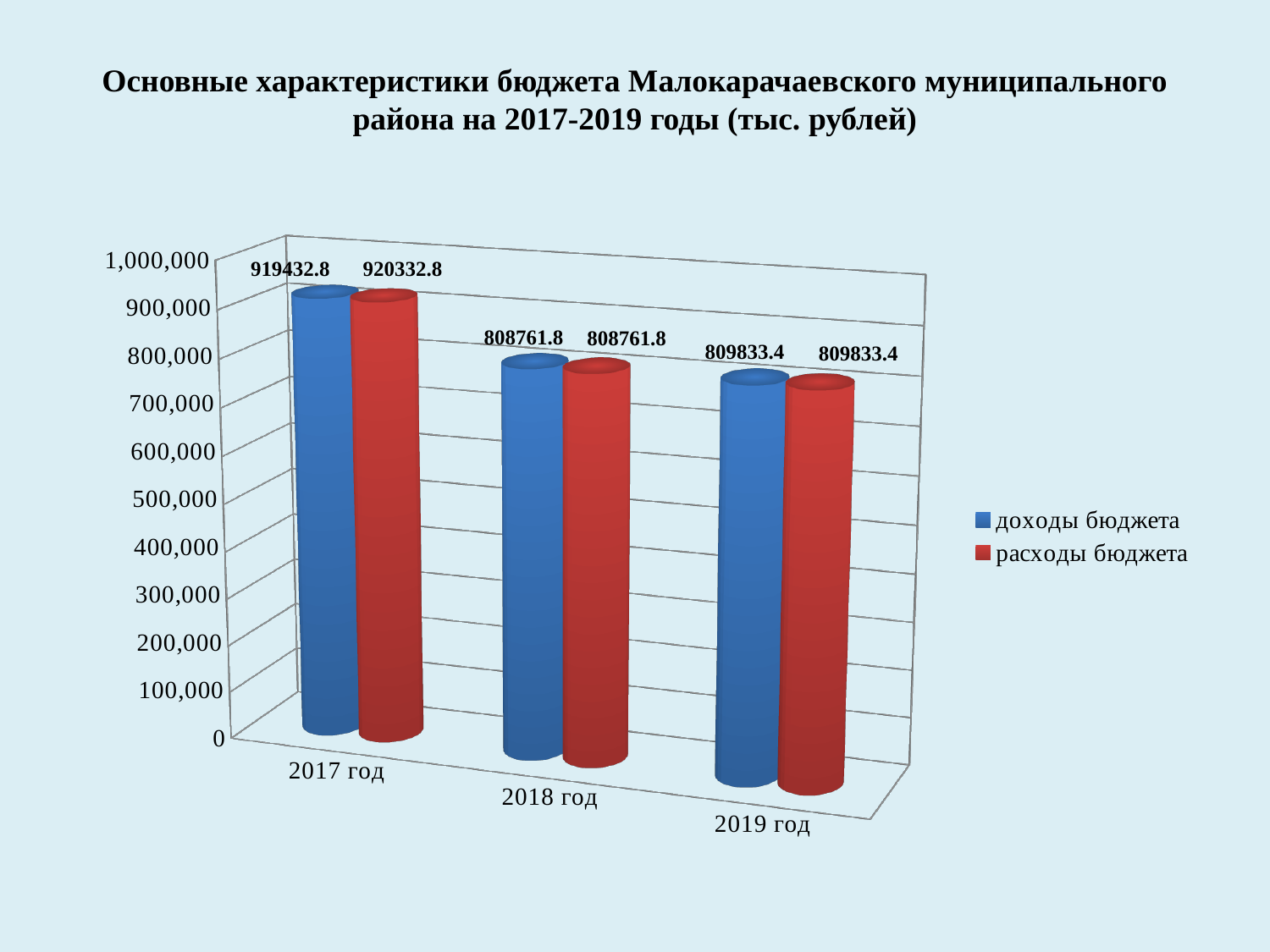
What is the difference between расходы бюджета and доходы бюджета in 2017 год? 900 By how much does доходы бюджета in 2017 год exceed доходы бюджета in 2018 год? 110671 Which is larger in 2017 год: доходы бюджета or расходы бюджета? расходы бюджета What kind of chart is shown on the slide? bar chart What is the value of расходы бюджета for 2019 год? 809833.4 In which year is доходы бюджета the highest? 2017 год What is the value of расходы бюджета for 2017 год? 920332.8 What is the value of доходы бюджета for 2018 год? 808761.8 How many series does the legend list? 2 Is the value of расходы бюджета for 2018 год greater or less than 900,000? less What is the value of доходы бюджета for 2017 год? 919432.8 In which year is расходы бюджета the lowest? 2018 год